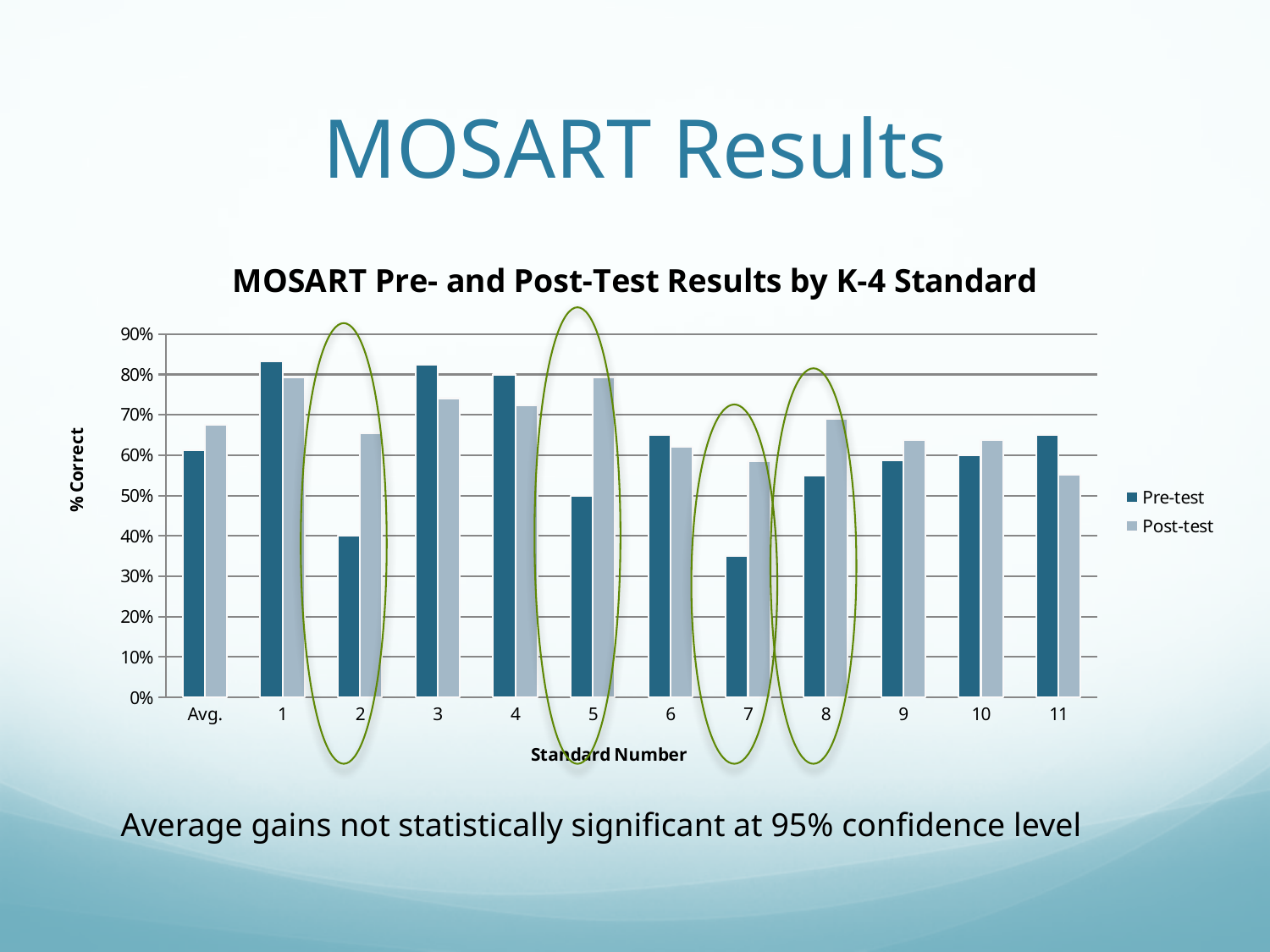
What is the label on the y axis of the chart? % Correct For Standard 11, which is larger, the Pre-test or the Post-test value? Pre-test How many categories are shown on the x axis? 12 For Standard 2, which is larger, the Pre-test or the Post-test value? Post-test How many series does the legend list? 2 What kind of chart is shown on the slide? bar chart What is the title of the chart? MOSART Pre- and Post-Test Results by K-4 Standard Is the Post-test value for Standard 8 greater or less than 60%? greater Is the Pre-test value for Standard 7 greater or less than 40%? less Is the Pre-test value for Standard 2 greater or less than 50%? less Which standard has the lowest Pre-test value? 7